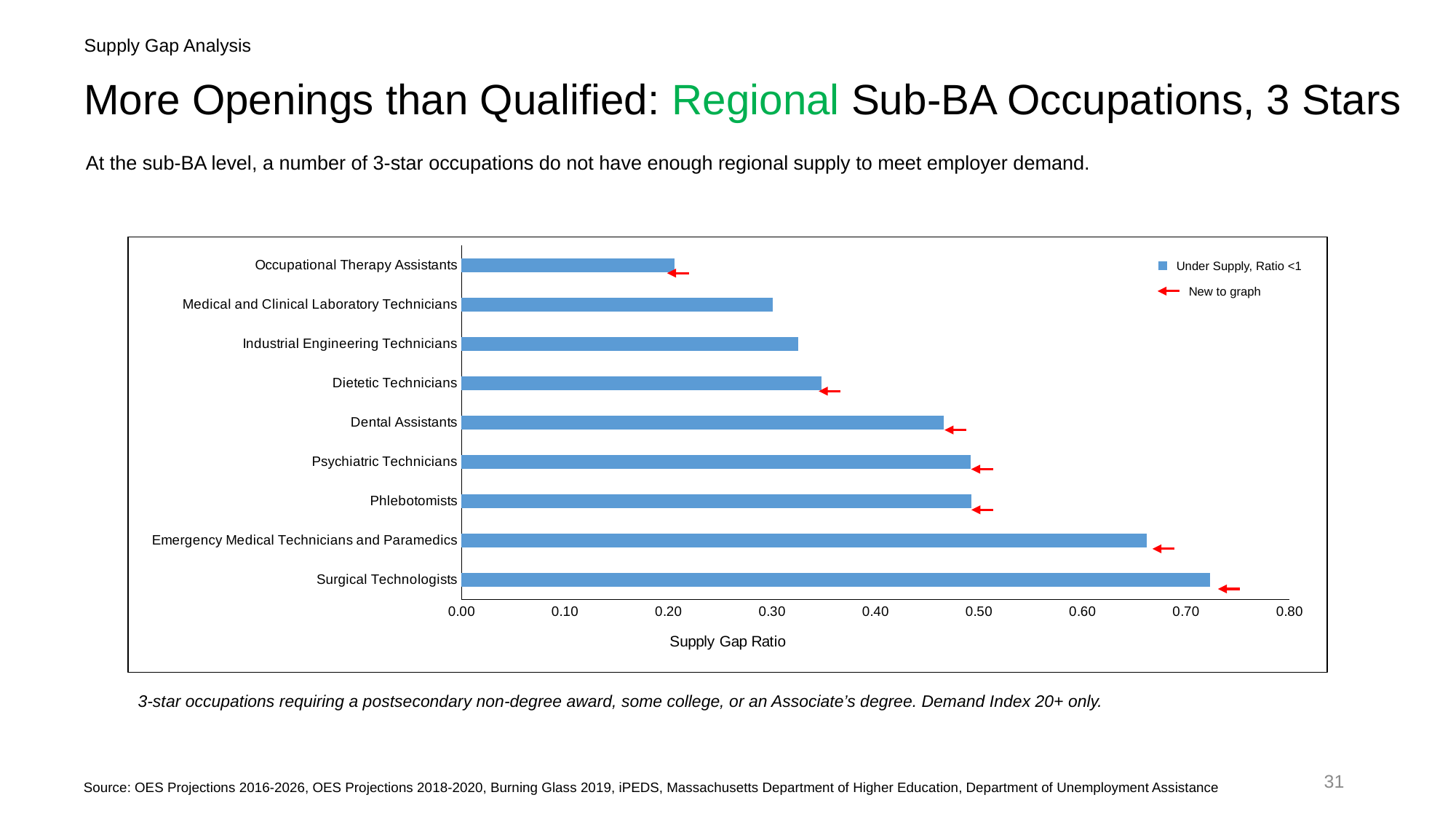
How many occupations are plotted in the chart? 9 Is the supply gap ratio for Dental Assistants greater or less than 0.50? less Is the supply gap ratio for Industrial Engineering Technicians greater or less than 0.30? greater Which occupation has the highest supply gap ratio? Surgical Technologists What is the title of the horizontal axis of the chart? Supply Gap Ratio Which occupation has the lowest supply gap ratio? Occupational Therapy Assistants Which has a larger supply gap ratio, Dental Assistants or Industrial Engineering Technicians? Dental Assistants Is the supply gap ratio for Emergency Medical Technicians and Paramedics greater or less than 0.60? greater What type of chart is shown on the slide? Bar chart According to the legend, what does a red arrow next to a bar indicate? New to graph